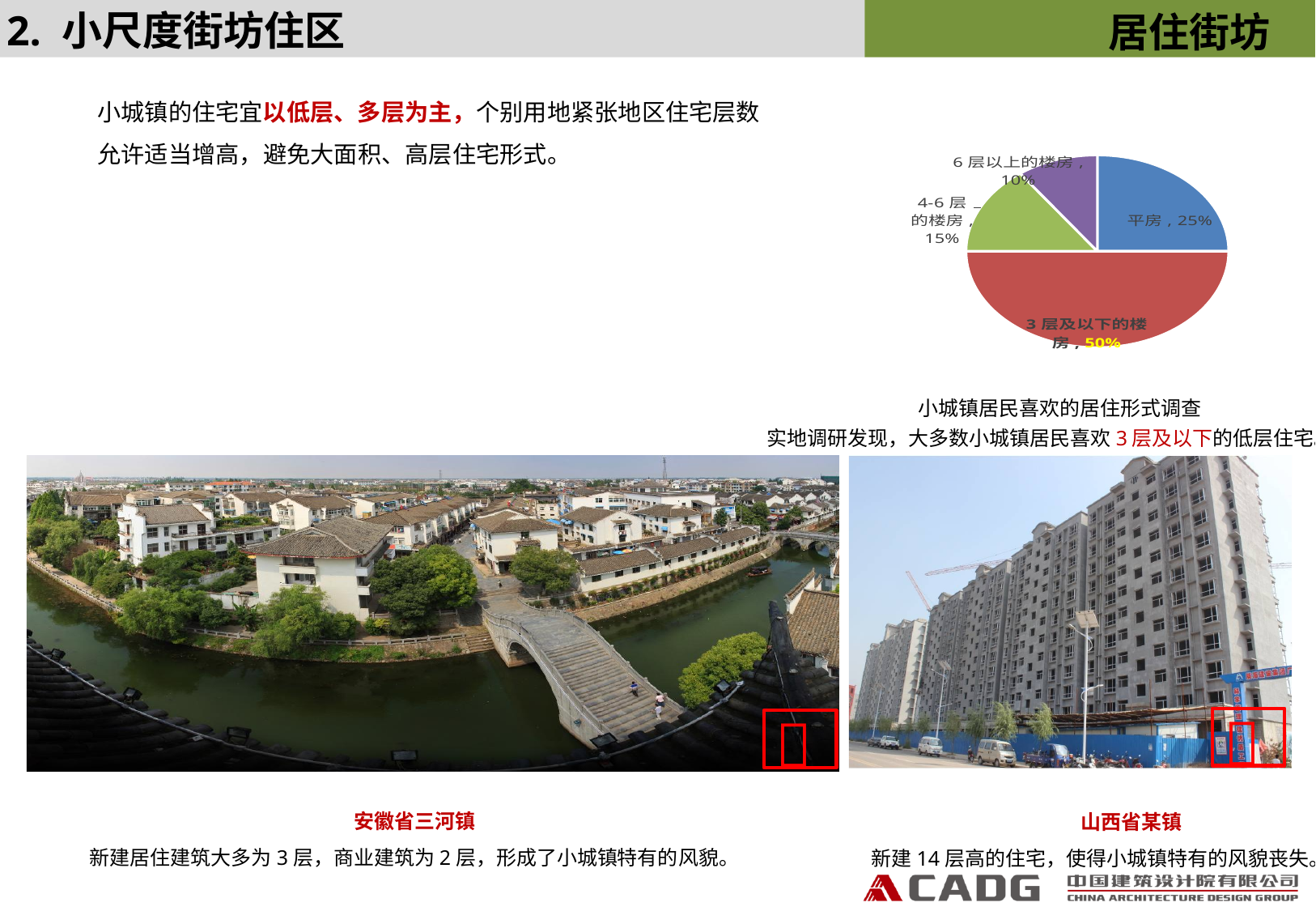
What share of the pie chart is labelled 4-6 层的楼房? 15% What share of the pie chart is labelled 6 层以上的楼房? 10% What share of the pie chart is labelled 3 层及以下的楼房? 50% What is the combined share of the 平房 and 4-6 层的楼房 slices? 40% What share of the pie chart is labelled 平房? 25% Which category has the smallest slice in the pie chart? 6 层以上的楼房 What is the difference in percentage points between the 3 层及以下的楼房 slice and the 平房 slice? 25 How many slices does the pie chart have? 4 Which slice is larger, 4-6 层的楼房 or 6 层以上的楼房? 4-6 层的楼房 Which category has the largest slice in the pie chart? 3 层及以下的楼房 What is the caption/title given below the pie chart? 小城镇居民喜欢的居住形式调查 What kind of chart is shown on the slide? pie chart